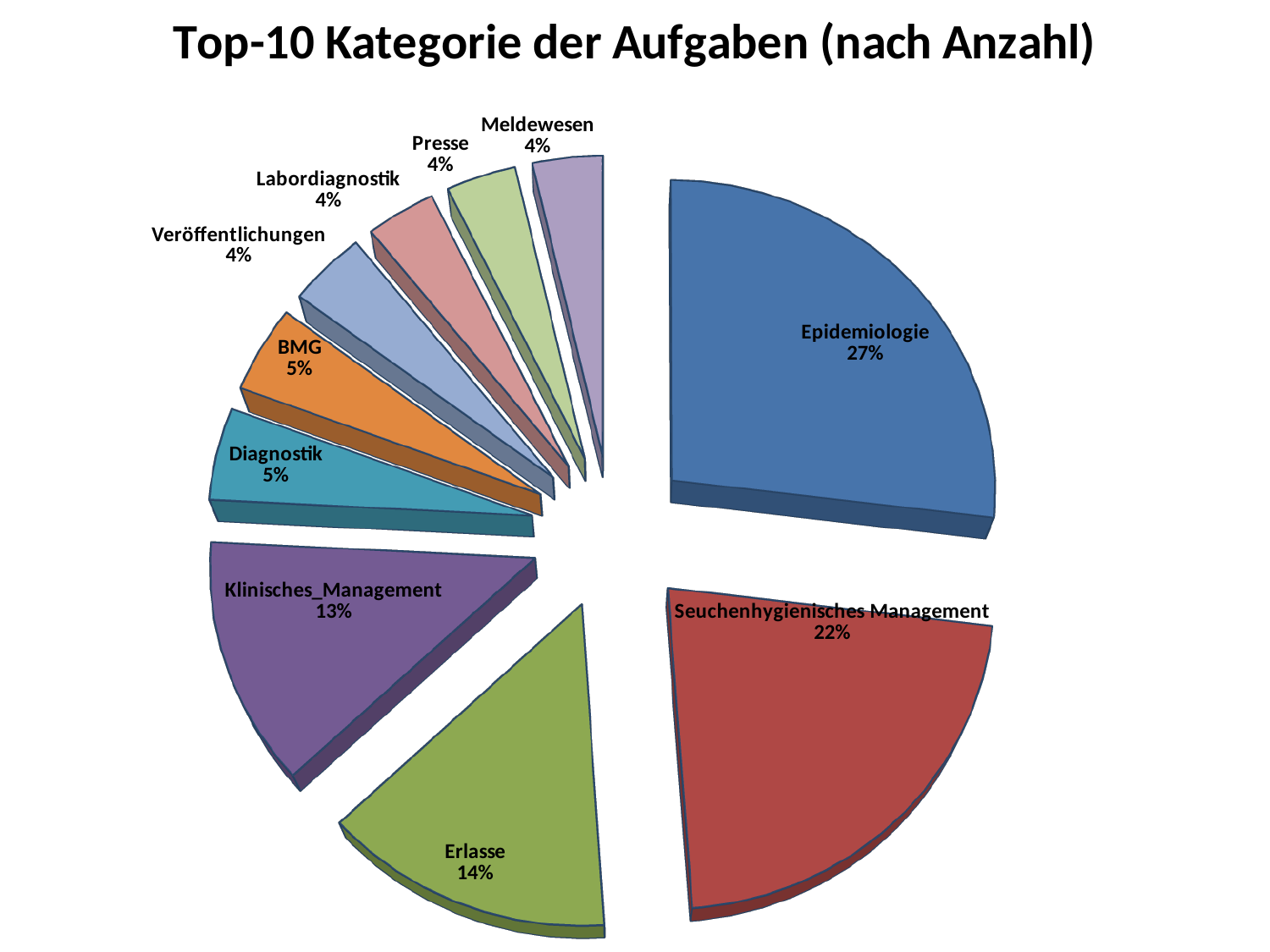
What is the difference between the shares of Epidemiologie and Seuchenhygienisches Management? 5% What is the value shown for Erlasse? 14% What share of the pie does Seuchenhygienisches Management have? 22% How many categories are shown in the pie chart? 10 Which is larger, the share for Erlasse or the share for Klinisches_Management? Erlasse What kind of chart is shown on the slide? pie chart What is the value shown for BMG? 5% Which category has the largest slice of the pie? Epidemiologie What is the value shown for Klinisches_Management? 13% What is the combined share of Diagnostik and BMG? 10% What is the title of the chart? Top-10 Kategorie der Aufgaben (nach Anzahl) What share of the pie does Epidemiologie have? 27%